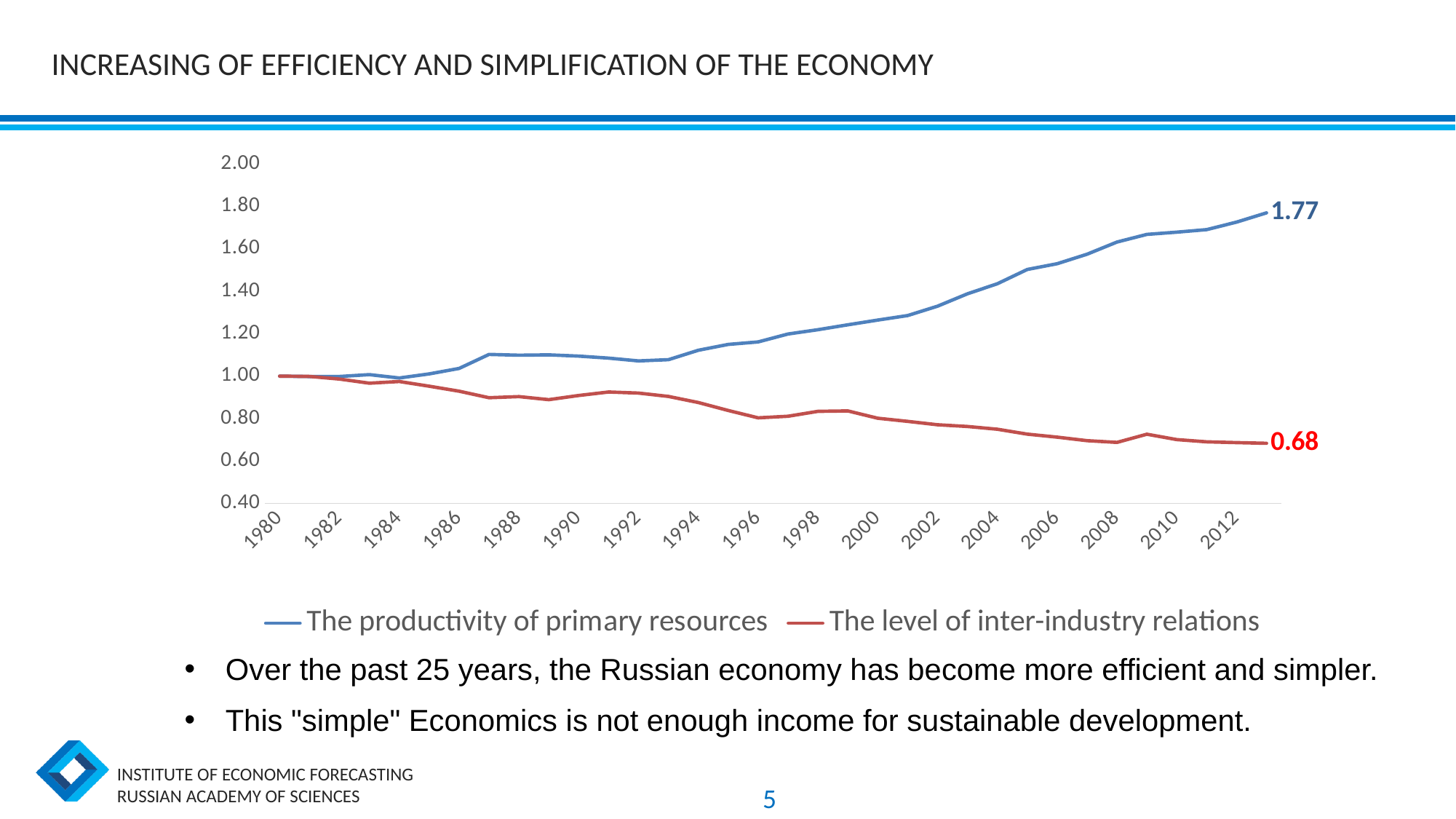
Is the value of the productivity of primary resources in 2006 greater or less than 1.40? greater What is the final labelled value of the level of inter-industry relations series? 0.68 What is the difference between the final labelled values of the two series (1.77 and 0.68)? 1.09 Is the value of the level of inter-industry relations in 2006 greater or less than 0.80? less What is the final labelled value of the productivity of primary resources series? 1.77 Is the value of the productivity of primary resources in 2000 greater or less than 1.00? greater What kind of chart is shown on the slide? line chart Which series ends at the higher value, the productivity of primary resources or the level of inter-industry relations? The productivity of primary resources Does the productivity of primary resources series generally rise or fall from 1980 to the end of the chart? rise How many series does the chart's legend list? 2 What colour is the line for the level of inter-industry relations? red Does the level of inter-industry relations series generally rise or fall from 1980 to the end of the chart? fall